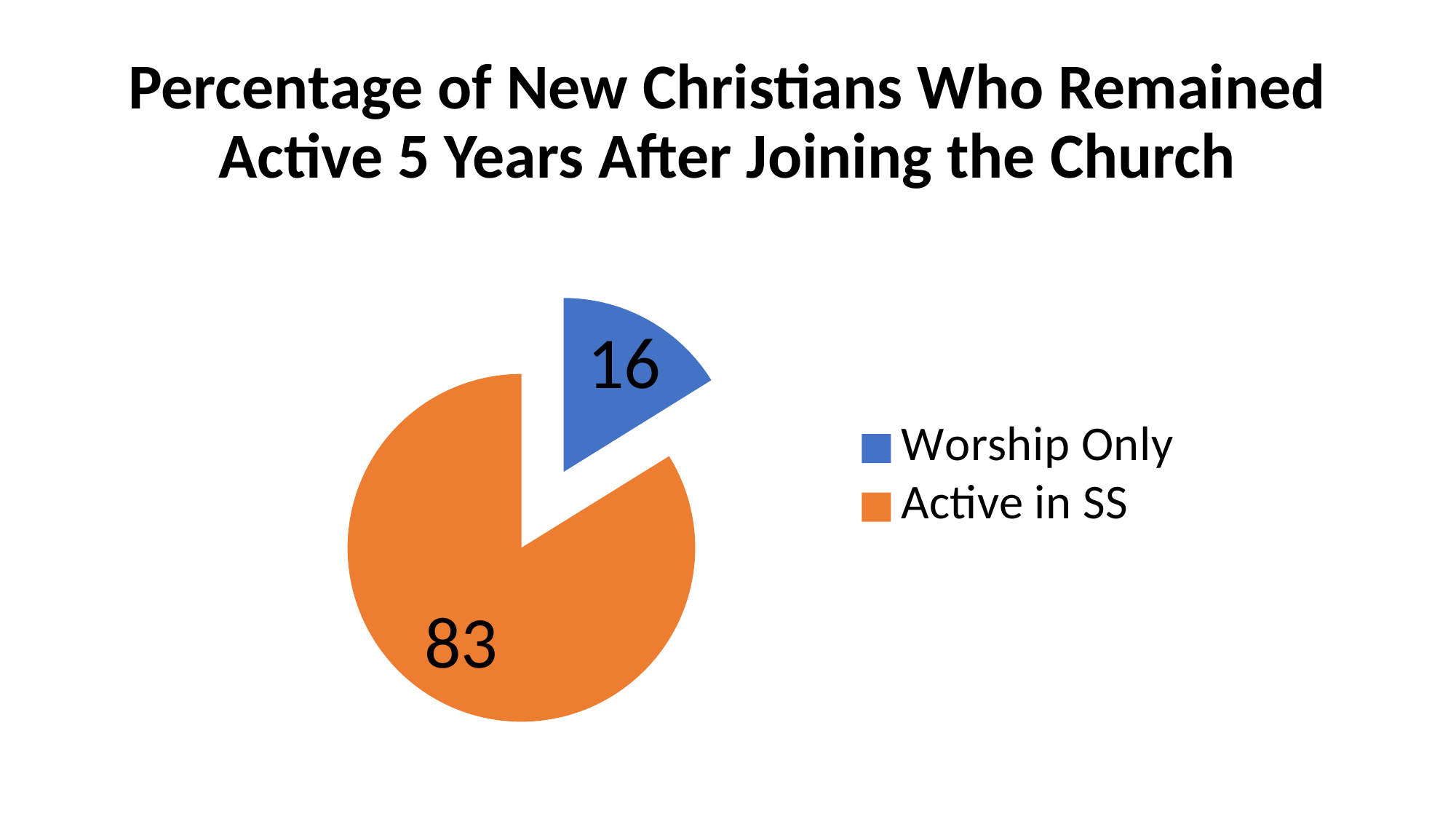
Which is larger, the value for Worship Only or the value for Active in SS? Active in SS What is the sum of the two values shown on the pie chart? 99 What colour is the Worship Only slice? Blue What is the title of the chart? Percentage of New Christians Who Remained Active 5 Years After Joining the Church Which category has the smallest slice of the pie? Worship Only How many slices does the pie chart have? 2 What value is shown for the Worship Only slice? 16 What kind of chart is shown on the slide? Pie chart How many entries does the legend list? 2 What value is shown for the Active in SS slice? 83 What is the difference between the Active in SS value and the Worship Only value? 67 Which category has the largest slice of the pie? Active in SS